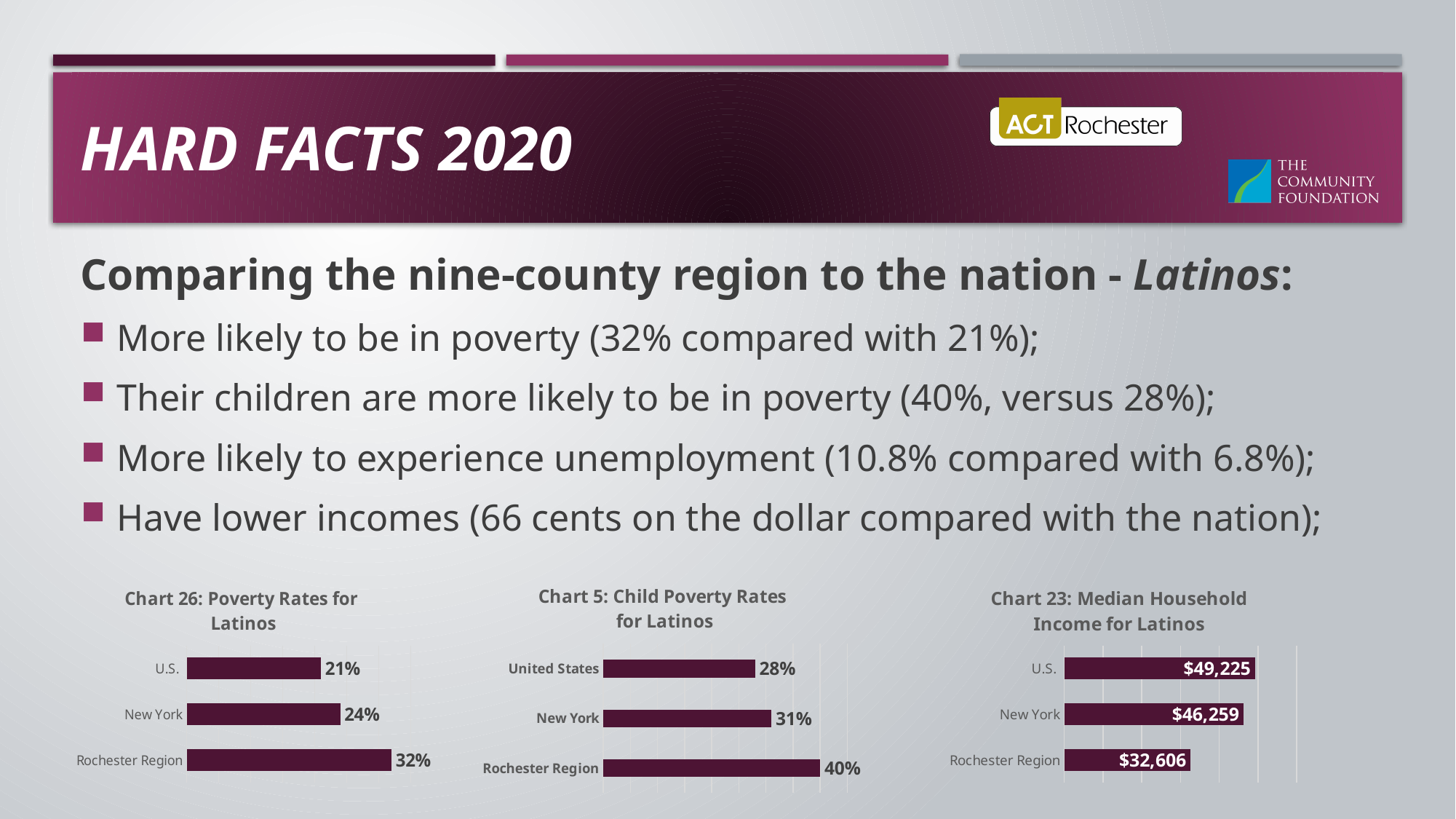
In Chart 23: Median Household Income for Latinos, what is the median household income for the Rochester Region? $32,606 In Chart 26: Poverty Rates for Latinos, what is the poverty rate for New York? 24% In Chart 5: Child Poverty Rates for Latinos, what is the child poverty rate for the United States? 28% In Chart 26: Poverty Rates for Latinos, what is the difference between the Rochester Region and U.S. poverty rates? 11% In Chart 5: Child Poverty Rates for Latinos, which category has the lowest child poverty rate? United States In Chart 23: Median Household Income for Latinos, is the median household income larger for New York or the Rochester Region? New York In Chart 23: Median Household Income for Latinos, which category has the highest median household income? U.S. In Chart 5: Child Poverty Rates for Latinos, what is the difference between the Rochester Region and New York child poverty rates? 9% In Chart 26: Poverty Rates for Latinos, which category has the highest poverty rate? Rochester Region How many categories are shown in Chart 26: Poverty Rates for Latinos? 3 What kind of chart is Chart 5: Child Poverty Rates for Latinos? Bar chart In Chart 23: Median Household Income for Latinos, what is the difference between the U.S. and New York median household incomes? $2,966